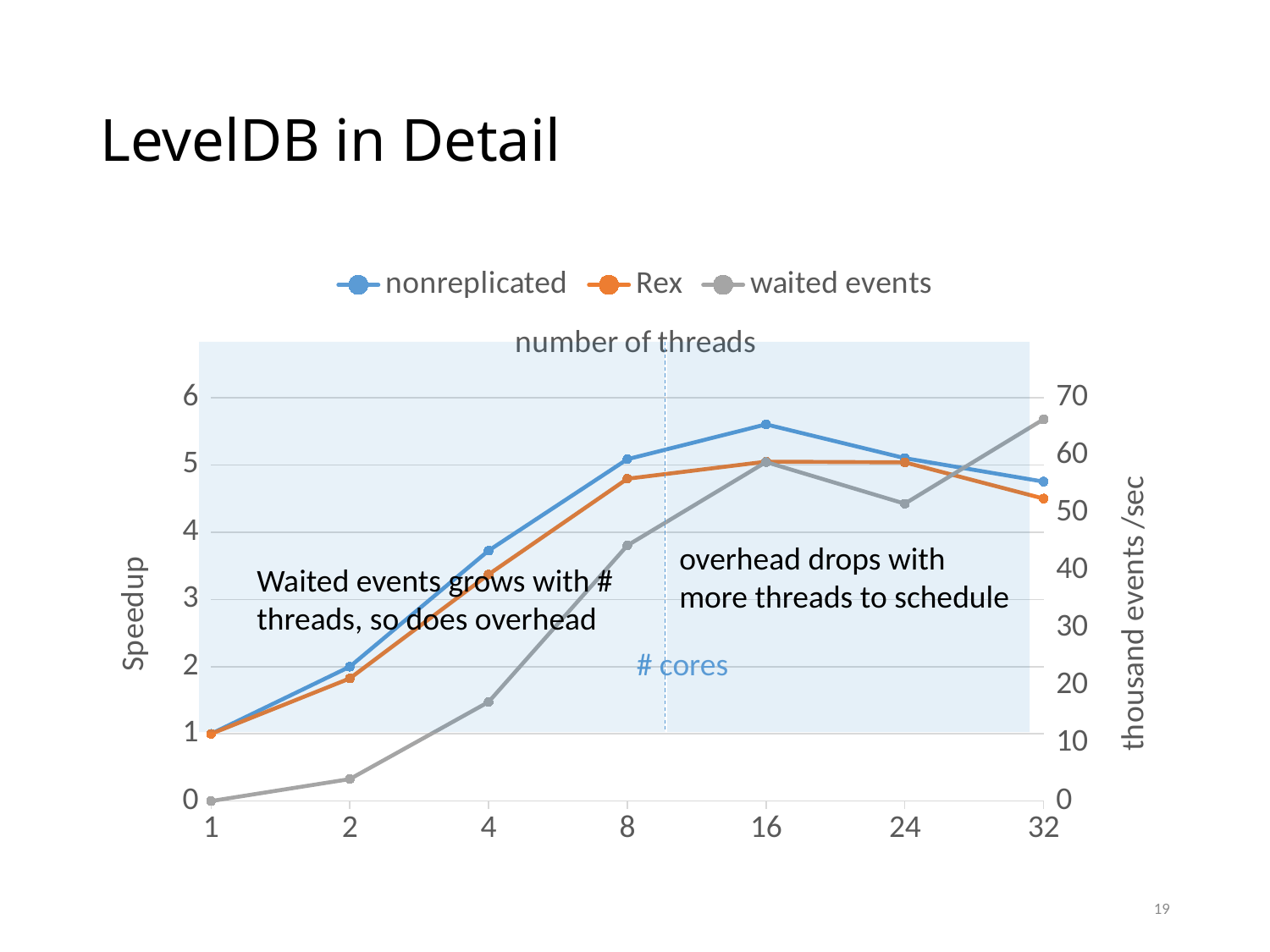
Is the value for waited events at 4 threads greater or less than 20 thousand events/sec? less At which number of threads is the waited events series highest? 32 Is the speedup for Rex at 32 threads greater or less than 5? less Does the waited events series rise or fall from 1 to 16 threads? rise Is the speedup for nonreplicated at 16 threads greater or less than 5? greater At which number of threads is the waited events series lowest? 1 How many thread counts are plotted along the x axis? 7 At 8 threads, which series has the higher speedup, nonreplicated or Rex? nonreplicated What kind of chart is shown on the slide? line chart How many series does the legend list? 3 At which number of threads does the nonreplicated series reach its highest speedup? 16